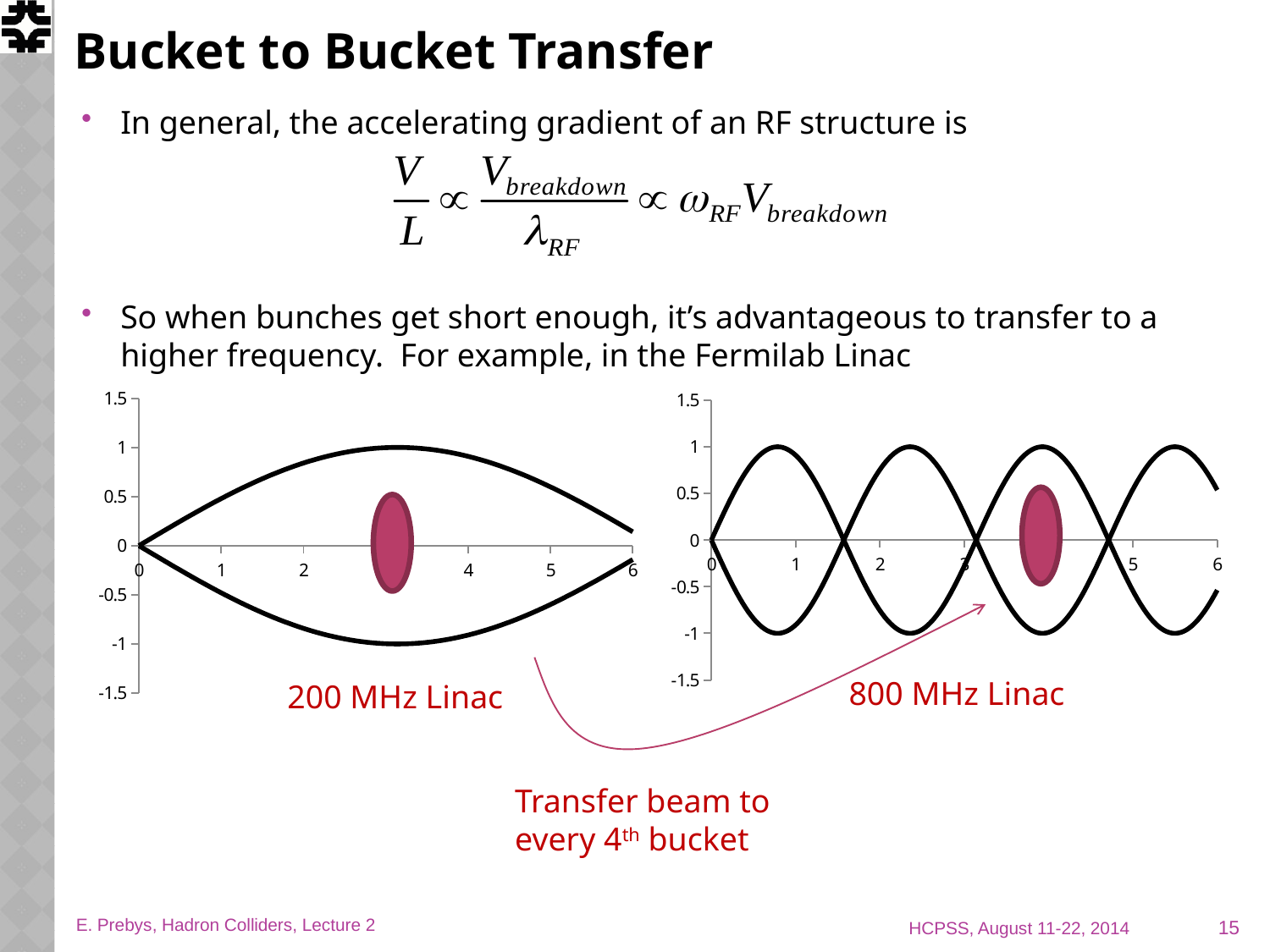
In the left chart (200 MHz Linac), does the upper curve rise or fall as x goes from 0 to 3? rise In the right chart (800 MHz Linac), what is the lowest value on the y axis? -1.5 In the left chart (200 MHz Linac), what is the maximum value reached by the upper curve? 1 In the right chart (800 MHz Linac), how many complete buckets (lens-shaped regions) are shown between x = 0 and x = 6? 3 How many charts are shown on the slide? 2 In the left chart (200 MHz Linac), what is the largest value shown on the x axis? 6 In the left chart (200 MHz Linac), is the peak of the upper curve at x = 3 greater or less than 0.5? greater Which chart shows more buckets across the same x range, the 200 MHz Linac chart or the 800 MHz Linac chart? 800 MHz Linac In the left chart (200 MHz Linac), what is the highest value on the y axis? 1.5 In the left chart (200 MHz Linac), what is the minimum value reached by the lower curve? -1 What kind of chart is the left chart labelled 200 MHz Linac? line chart In the right chart (800 MHz Linac), is the peak of the upper curve near x = 1 greater or less than 1.5? less